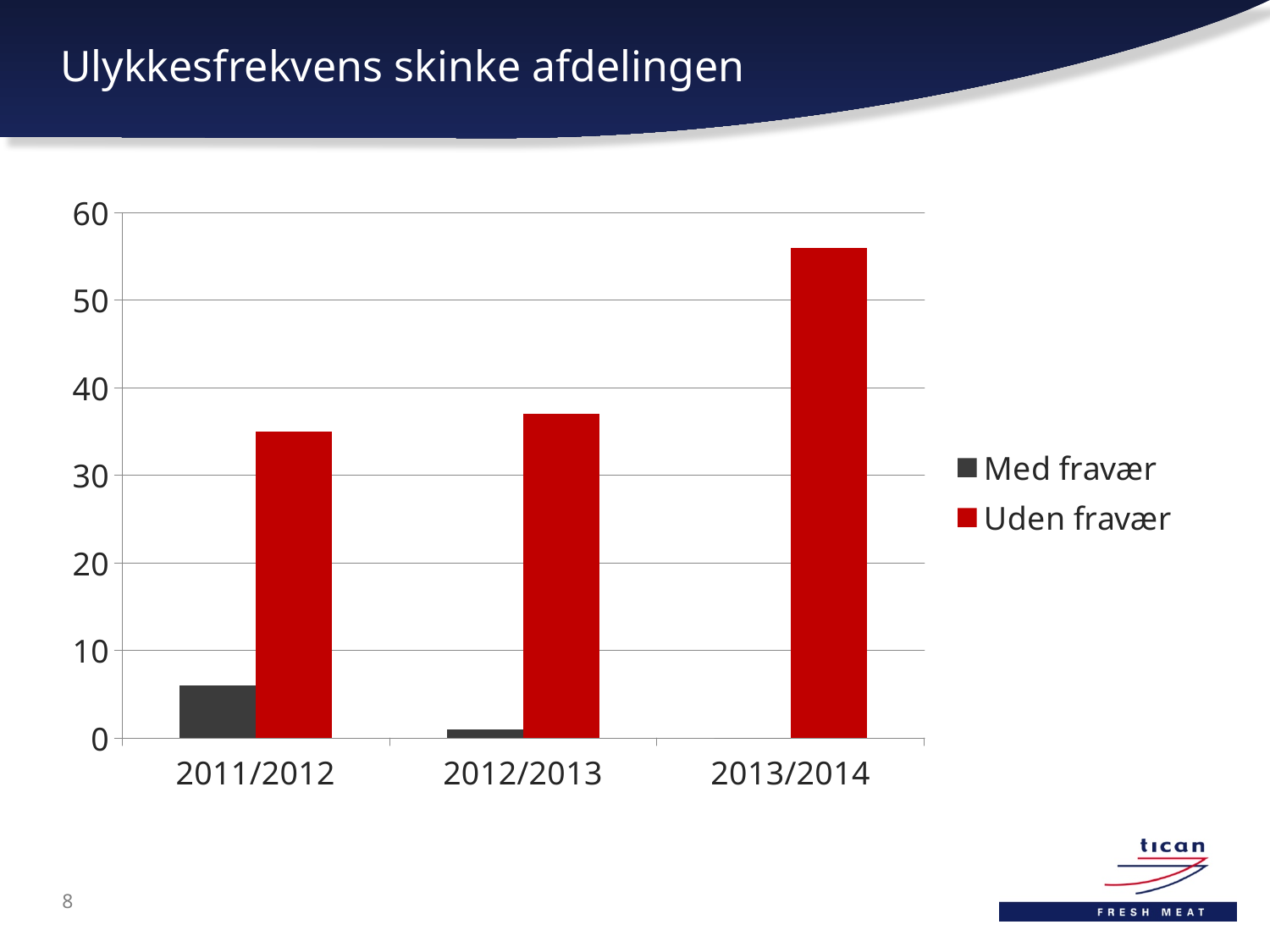
How many series does the legend list? 2 How many categories are shown on the x axis? 3 Is the value for Uden fravær in 2011/2012 greater or less than 40? less Which category has the highest value for Uden fravær? 2013/2014 Do the values for Uden fravær rise or fall from 2011/2012 to 2013/2014? rise Is the value for Uden fravær in 2012/2013 greater or less than 30? greater Is the value for Uden fravær in 2013/2014 greater or less than 50? greater Which category has the highest value for Med fravær? 2011/2012 What kind of chart is shown on the slide? bar chart Which is larger in 2012/2013, Med fravær or Uden fravær? Uden fravær What colour are the Uden fravær bars? red